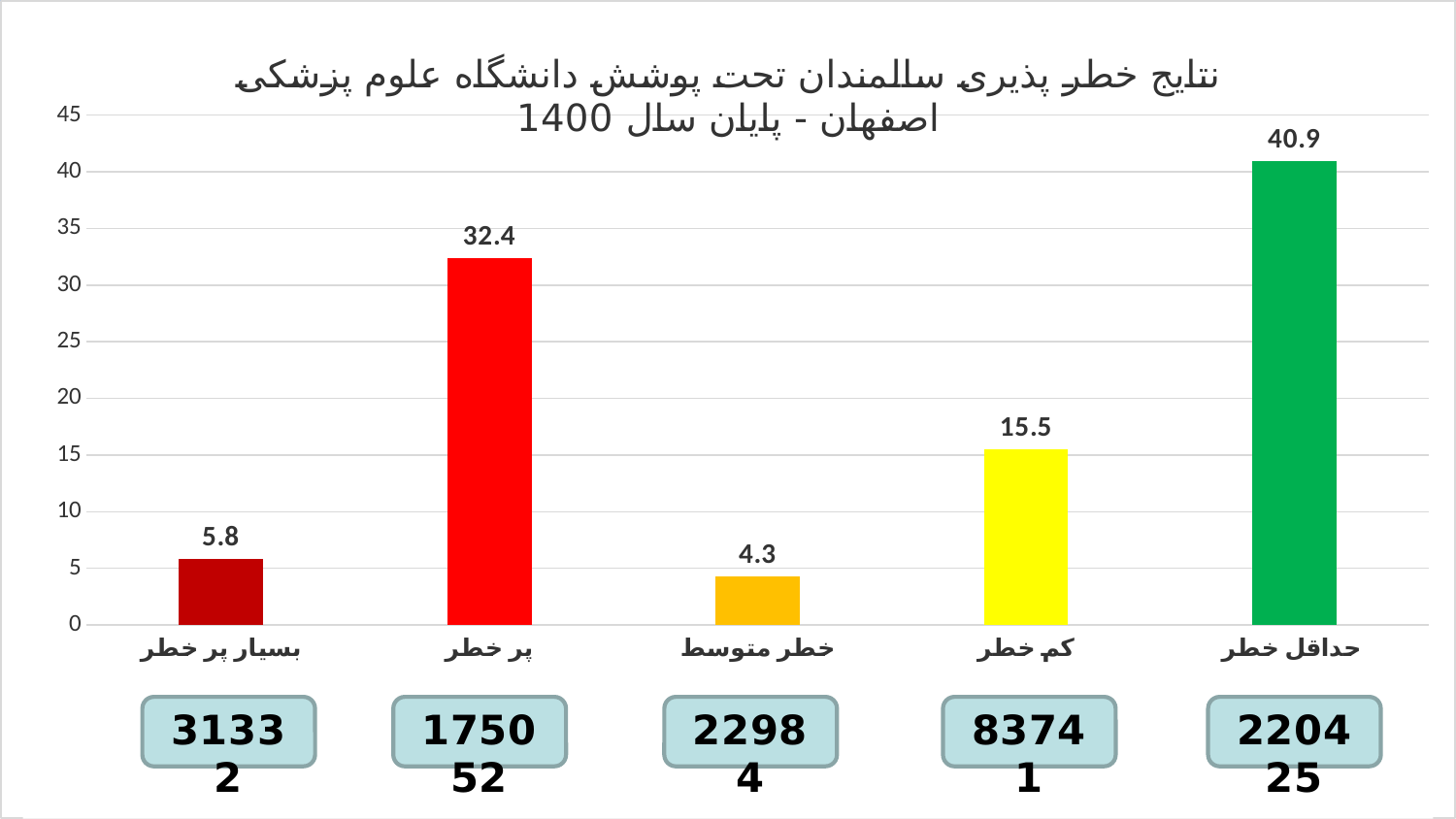
Which is larger, the value for "کم خطر" or the value for "بسیار پر خطر"? کم خطر How many categories are shown on the x axis? 5 What kind of chart is shown on the slide? bar chart What is the difference between the values for "بسیار پر خطر" and "خطر متوسط"? 1.5 Which category has the highest value? حداقل خطر What is the value for the category "کم خطر"? 15.5 Which category has the lowest value? خطر متوسط What is the value for the category "پر خطر"? 32.4 What colour is the bar for "حداقل خطر"? green What is the difference between the values for "حداقل خطر" and "پر خطر"? 8.5 What is the value for the category "حداقل خطر"? 40.9 Is the value for "پر خطر" greater or less than 30? greater